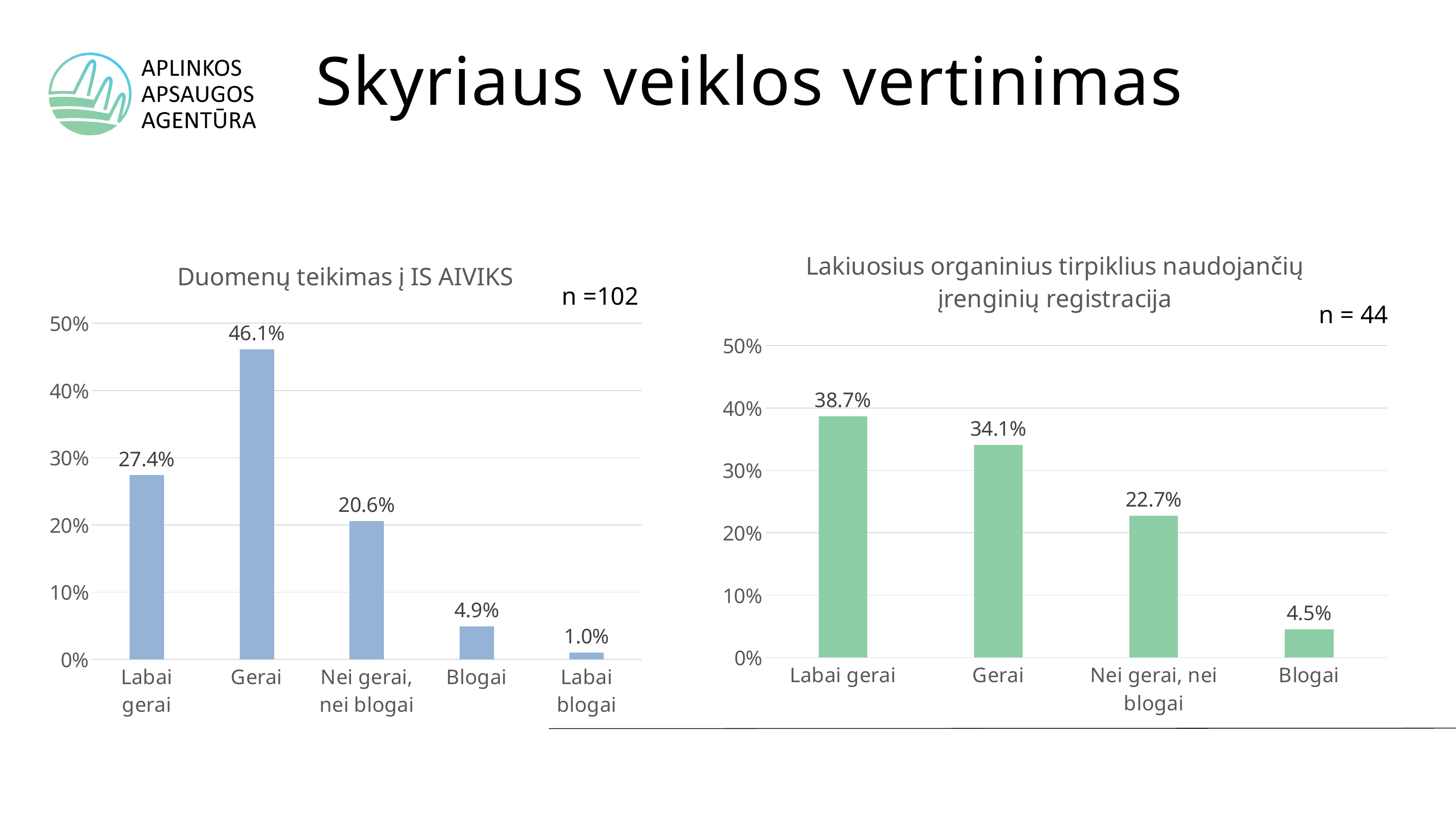
In the 'Lakiuosius organinius tirpiklius naudojančių įrenginių registracija' chart, what is the value for Labai gerai? 38.7% In the 'Duomenų teikimas į IS AIVIKS' chart, what is the difference between Gerai and Labai gerai? 18.7% What type of chart is the 'Duomenų teikimas į IS AIVIKS' chart? Bar chart In the 'Duomenų teikimas į IS AIVIKS' chart, which category has the highest value? Gerai In the 'Lakiuosius organinius tirpiklius naudojančių įrenginių registracija' chart, how many categories are shown? 4 In the 'Duomenų teikimas į IS AIVIKS' chart, how many categories are shown? 5 In the 'Lakiuosius organinius tirpiklius naudojančių įrenginių registracija' chart, what is the value for Nei gerai, nei blogai? 22.7% In the 'Duomenų teikimas į IS AIVIKS' chart, which category has the lowest value? Labai blogai In the 'Duomenų teikimas į IS AIVIKS' chart, what is the value for Labai blogai? 1.0% In the 'Duomenų teikimas į IS AIVIKS' chart, what is the value for Gerai? 46.1% In the 'Lakiuosius organinius tirpiklius naudojančių įrenginių registracija' chart, which category has the lowest value? Blogai In the 'Lakiuosius organinius tirpiklius naudojančių įrenginių registracija' chart, which is larger, Labai gerai or Gerai? Labai gerai